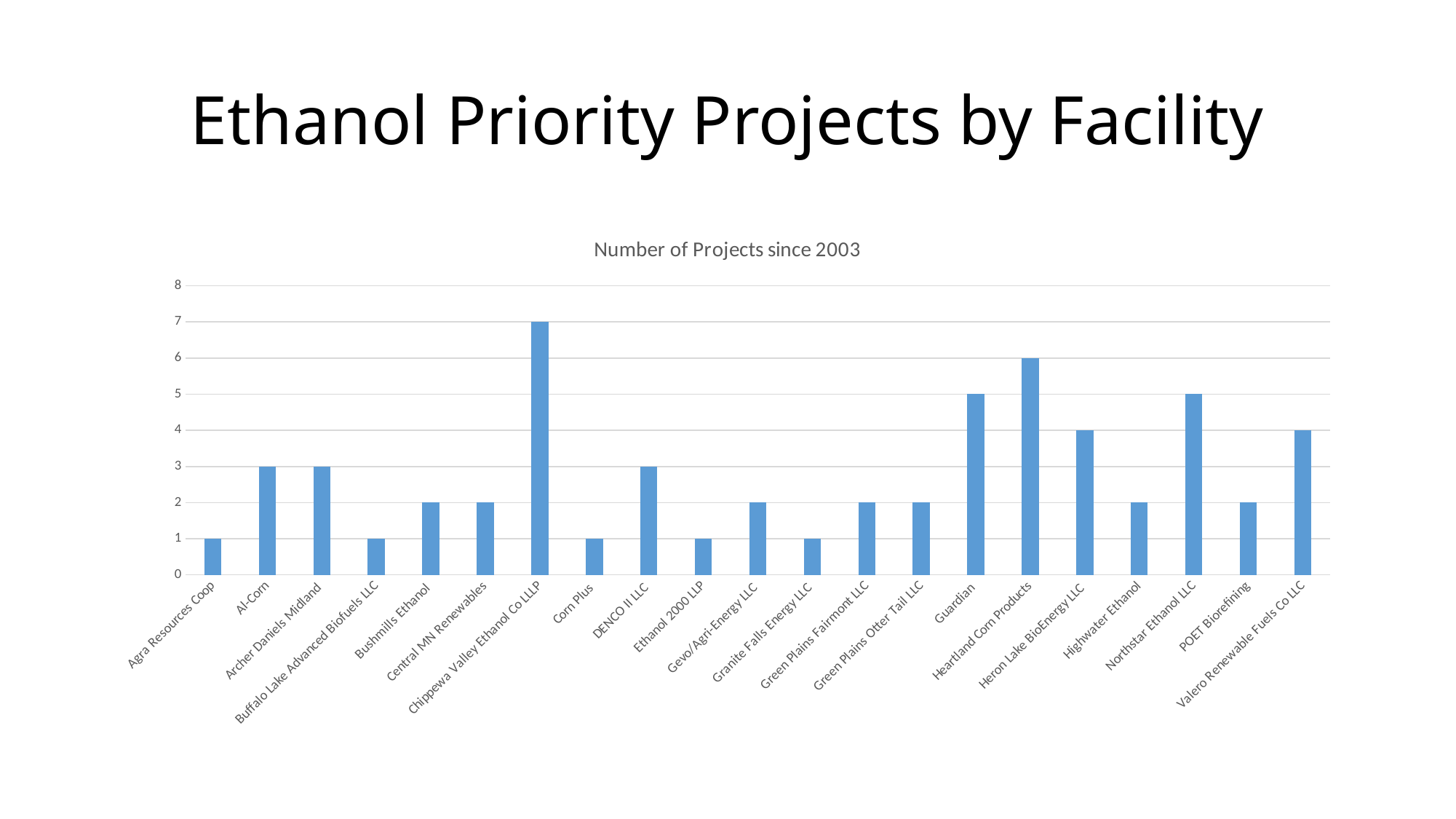
What is the difference in number of projects between Guardian and Highwater Ethanol? 3 Which facility has the highest number of projects? Chippewa Valley Ethanol Co LLLP How many facilities are shown on the chart? 21 What is the title of the chart? Number of Projects since 2003 Which has more projects, Guardian or Valero Renewable Fuels Co LLC? Guardian What is the number of projects for Chippewa Valley Ethanol Co LLLP? 7 What kind of chart is shown on the slide? Bar chart What is the number of projects for DENCO II LLC? 3 Is the value for Northstar Ethanol LLC greater or less than 4? greater What is the number of projects for Heartland Corn Products? 6 What is the difference in number of projects between Chippewa Valley Ethanol Co LLLP and Heartland Corn Products? 1 What is the number of projects for Heron Lake BioEnergy LLC? 4